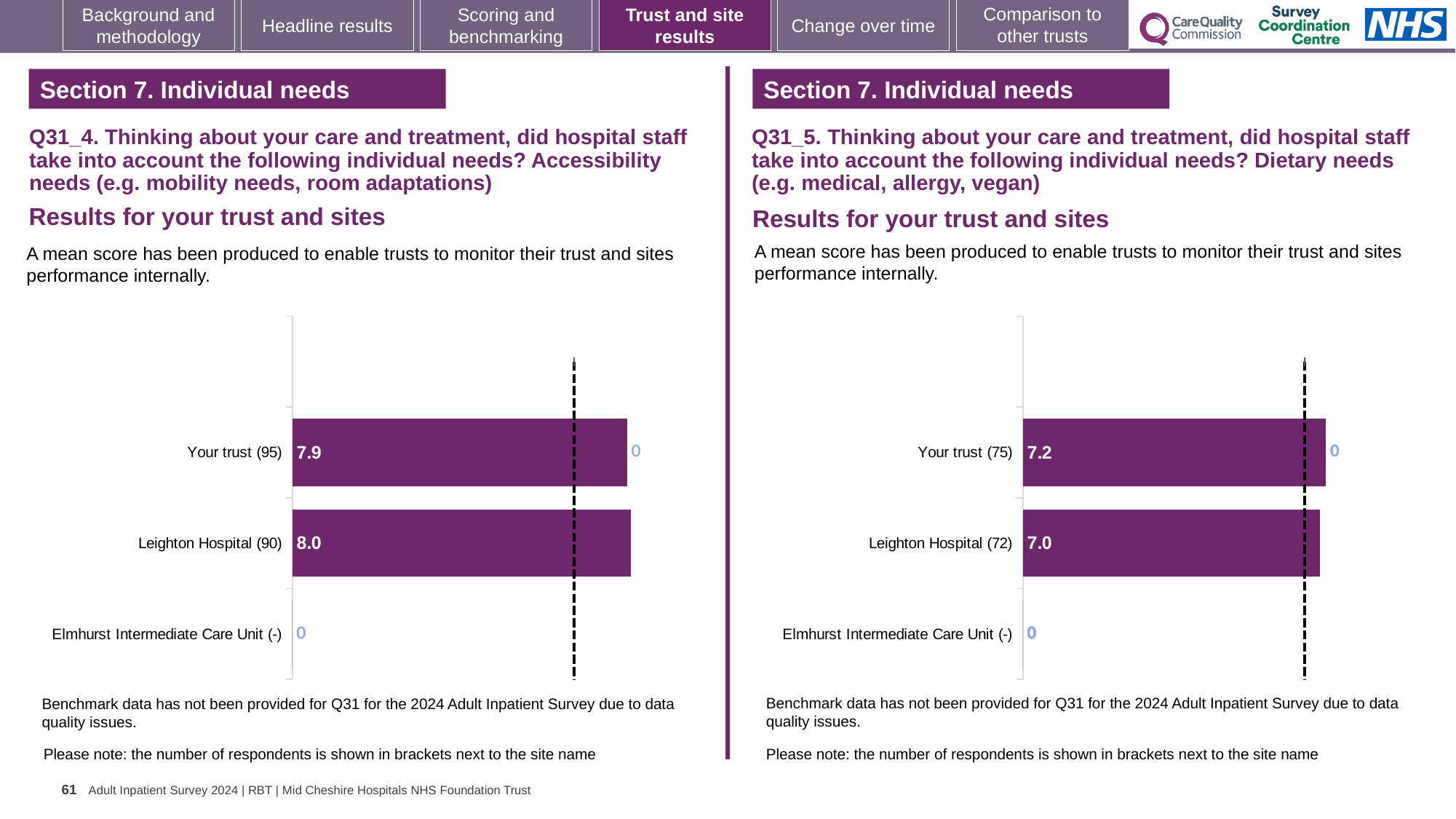
On the left chart (Q31_4, Accessibility needs), how many respondents are shown in brackets for Leighton Hospital? 90 On the left chart (Q31_4, Accessibility needs), which has the higher score, Your trust or Leighton Hospital? Leighton Hospital On the right chart (Q31_5, Dietary needs), what is the difference between the Your trust score and the Leighton Hospital score? 0.2 On the right chart (Q31_5, Dietary needs), what is the mean score for Your trust? 7.2 What type of chart is used on the right side of the slide (Q31_5, Dietary needs)? Bar chart On the left chart (Q31_4, Accessibility needs), what is the mean score for Leighton Hospital? 8.0 On the right chart (Q31_5, Dietary needs), which has the higher score, Your trust or Leighton Hospital? Your trust On the left chart (Q31_4, Accessibility needs), what is the mean score for Your trust? 7.9 On the right chart (Q31_5, Dietary needs), what is the mean score for Leighton Hospital? 7.0 On the left chart (Q31_4, Accessibility needs), what is the difference between the Leighton Hospital score and the Your trust score? 0.1 How many categories are listed on the left chart (Q31_4, Accessibility needs)? 3 On the right chart (Q31_5, Dietary needs), how many respondents are shown in brackets for Your trust? 75